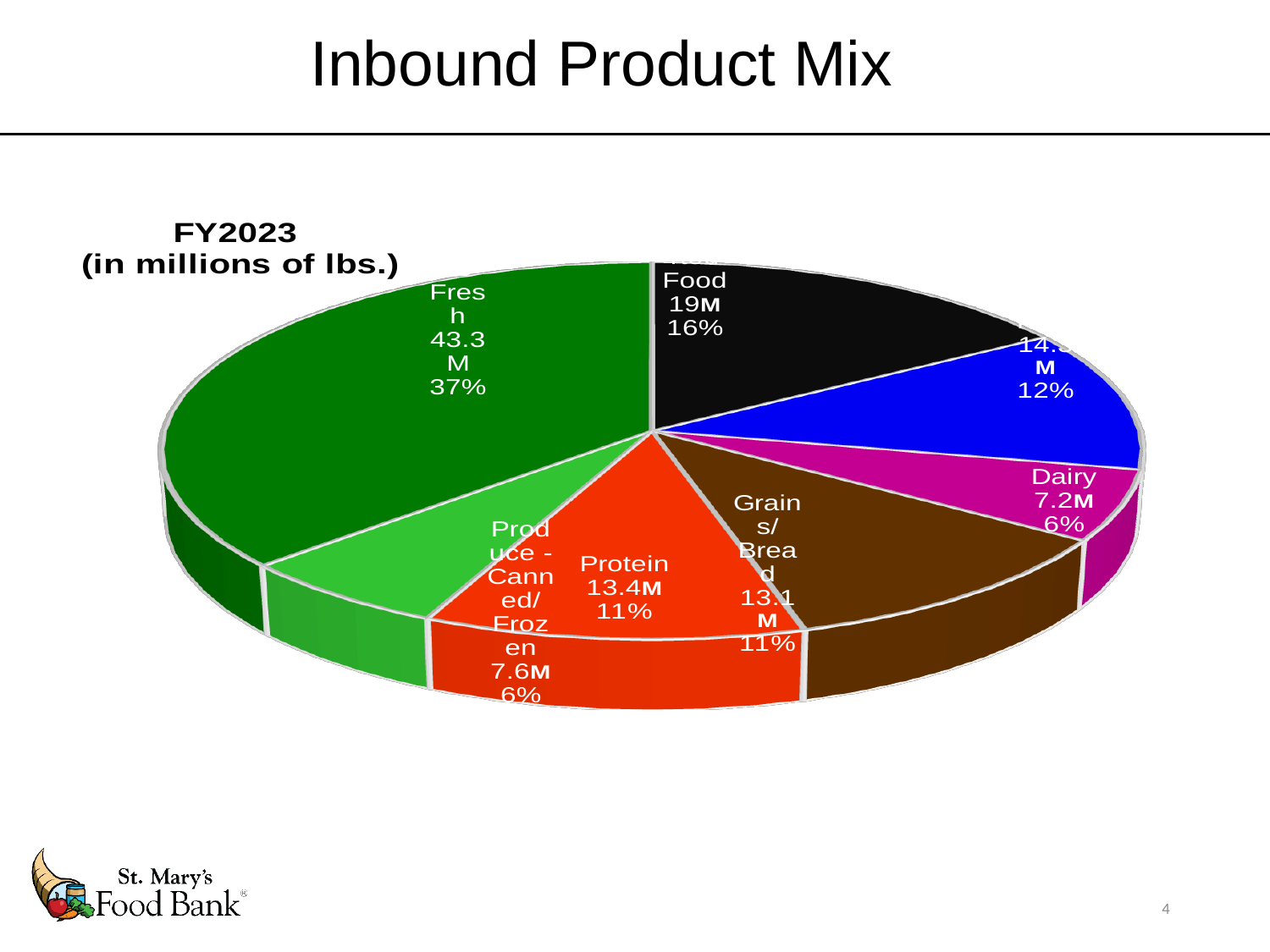
What is the title printed next to the pie chart? FY2023 (in millions of lbs.) What is the value shown for Grains/Bread? 13.1M What is the value shown for Produce - Canned/Frozen? 7.6M How many slices does the pie chart have? 7 What is the value shown for Dairy? 7.2M What share of the pie does the Fresh slice represent? 37% What is the value shown for Protein? 13.4M What is the value shown for the Fresh slice? 43.3M What kind of chart is shown on the slide? pie chart What is the difference between the Fresh value and the Protein value? 29.9M Which slice is the largest in the pie chart? Fresh Which is larger, Protein or Grains/Bread? Protein